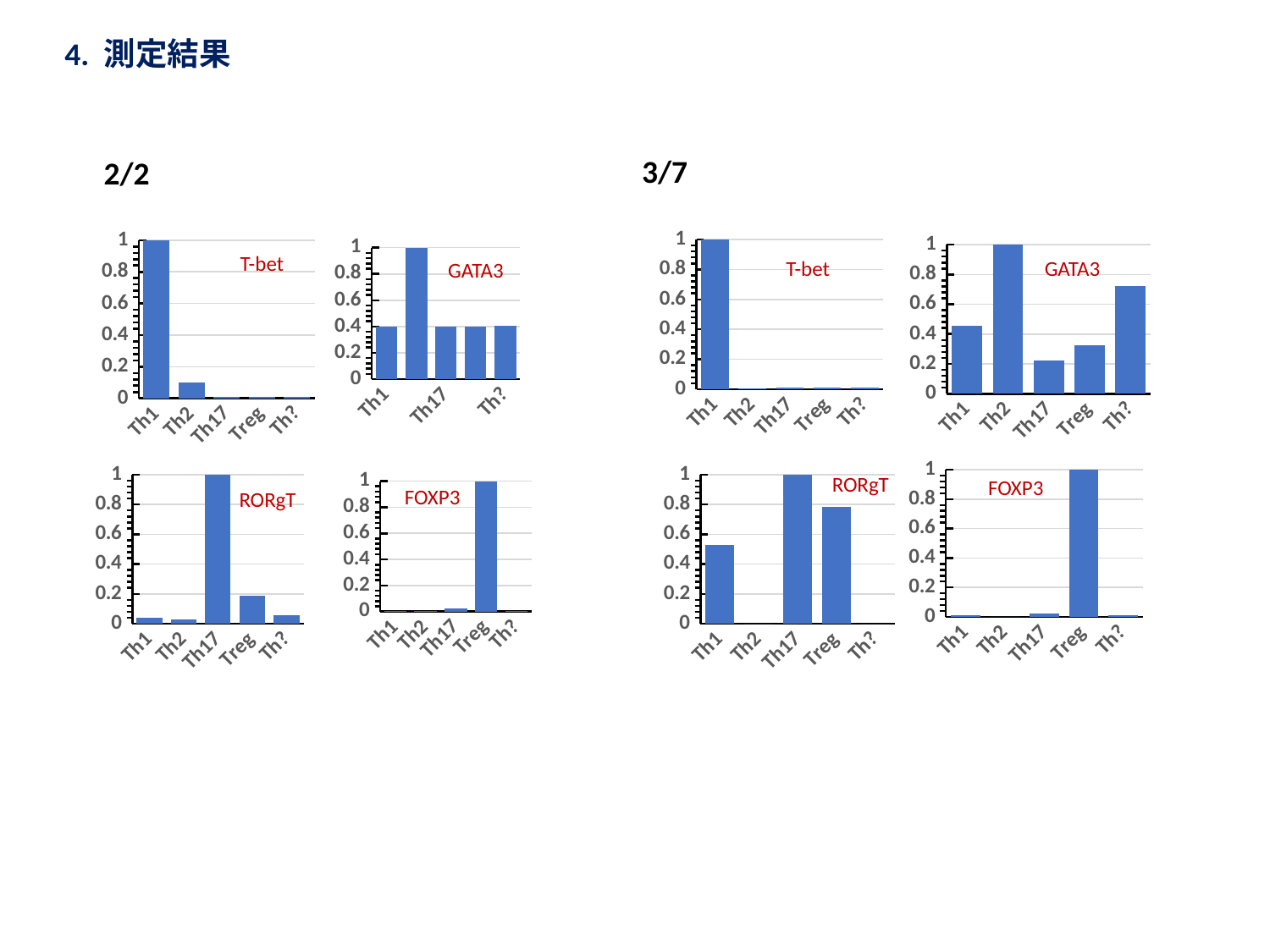
What kind of chart is the 3/7 T-bet chart? bar chart In the 3/7 RORgT chart, which is larger, the value for Th17 or the value for Treg? Th17 In the 3/7 GATA3 chart, which category has the lowest value? Th17 In the 2/2 GATA3 chart, is the value for Th1 greater or less than 0.6? less In the 3/7 GATA3 chart, is the value for Th? greater or less than 0.6? greater In the 2/2 T-bet chart, what is the value for Th1? 1 In the 2/2 FOXP3 chart, which category has the highest value? Treg In the 3/7 RORgT chart, is the value for Th1 greater or less than 0.4? greater In the 2/2 T-bet chart, which category has the highest value? Th1 How many categories are shown on the x axis of the 3/7 FOXP3 chart? 5 In the 2/2 GATA3 chart, which category has the highest value? Th2